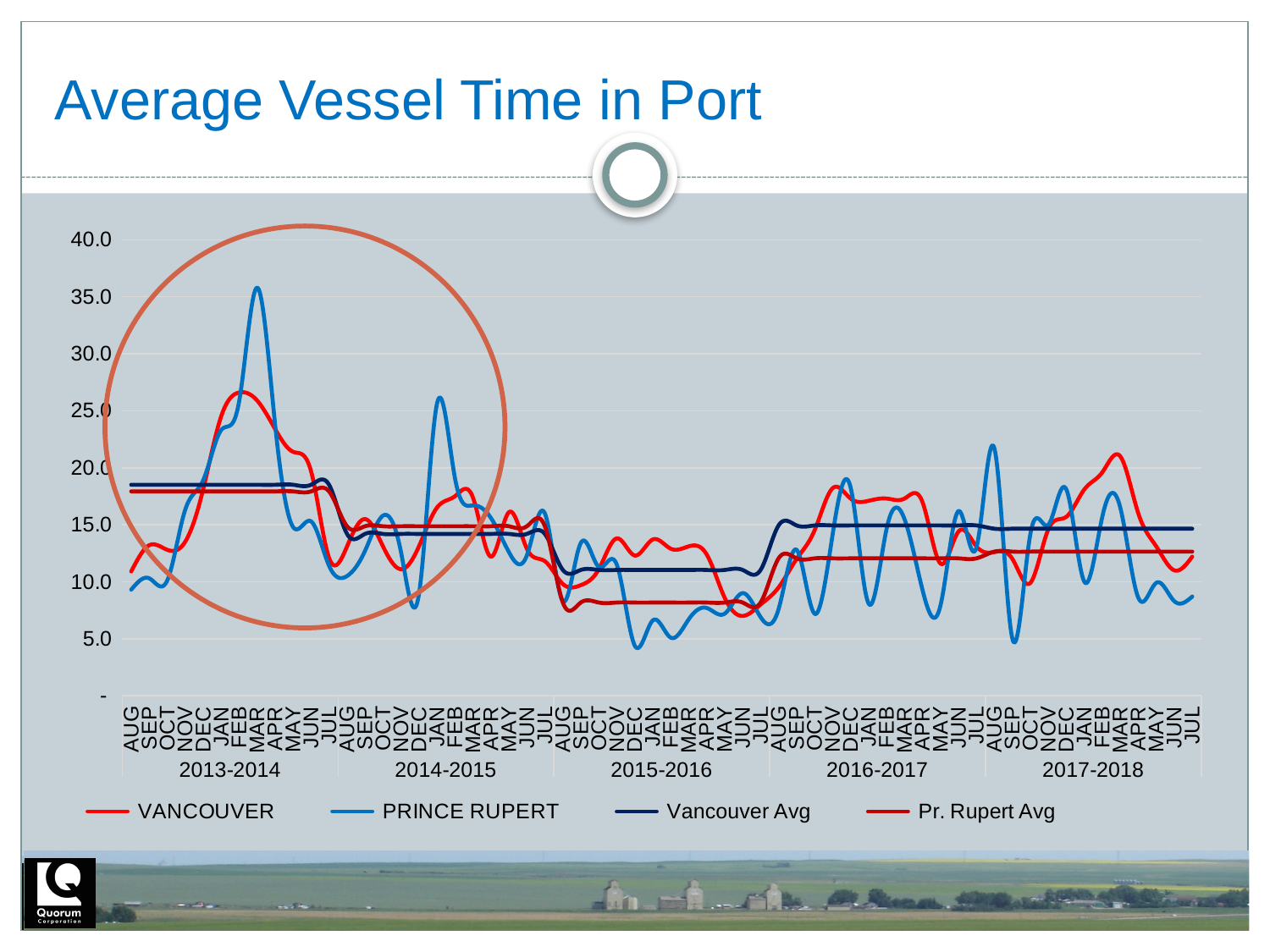
What kind of chart is shown on the slide? line chart What is the highest value shown on the y axis? 40.0 In which crop-year group does the PRINCE RUPERT line reach its highest peak? 2013-2014 How many crop-year groups are labelled along the x axis? 5 Which series reaches the highest value anywhere on the chart? PRINCE RUPERT What is the title of the chart? Average Vessel Time in Port Is the peak value of VANCOUVER in 2013-2014 greater or less than 20.0? greater Is the lowest value of PRINCE RUPERT in 2015-2016 greater or less than 10.0? less During 2016-2017, is the Vancouver Avg line higher or lower than the Pr. Rupert Avg line? higher Is the Pr. Rupert Avg value during 2015-2016 greater or less than 10.0? less How many series does the legend list? 4